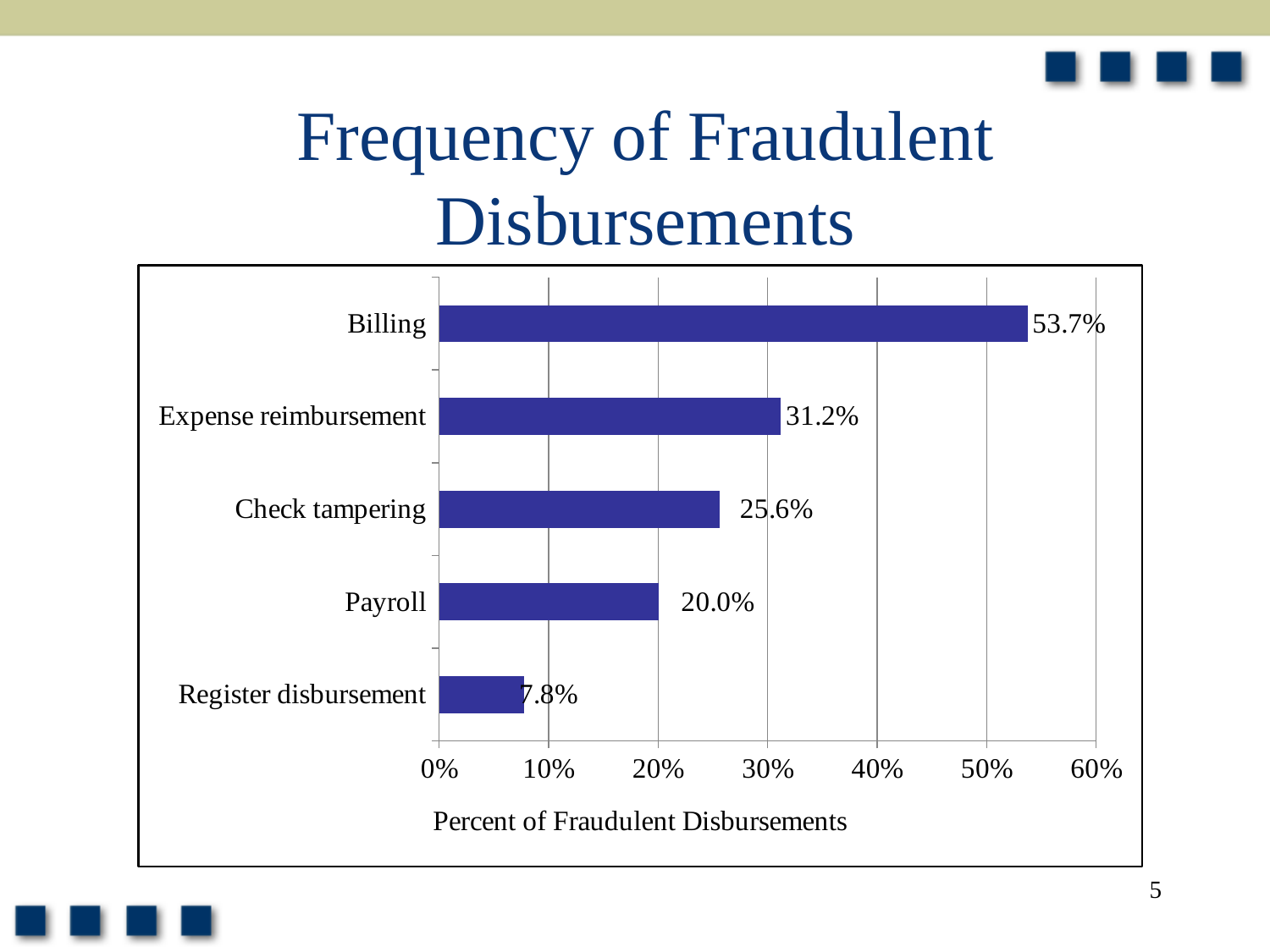
How many categories are shown in the chart? 5 Which category has the highest value? Billing What is the value for Check tampering? 25.6% What is the value for Billing? 53.7% Which is larger, the value for Check tampering or the value for Payroll? Check tampering What is the value for Register disbursement? 7.8% Which category has the lowest value? Register disbursement What is the difference between the values for Billing and Expense reimbursement? 22.5% What is the label of the horizontal axis? Percent of Fraudulent Disbursements What is the value for Payroll? 20.0% What is the value for Expense reimbursement? 31.2% What kind of chart is shown on the slide? Bar chart